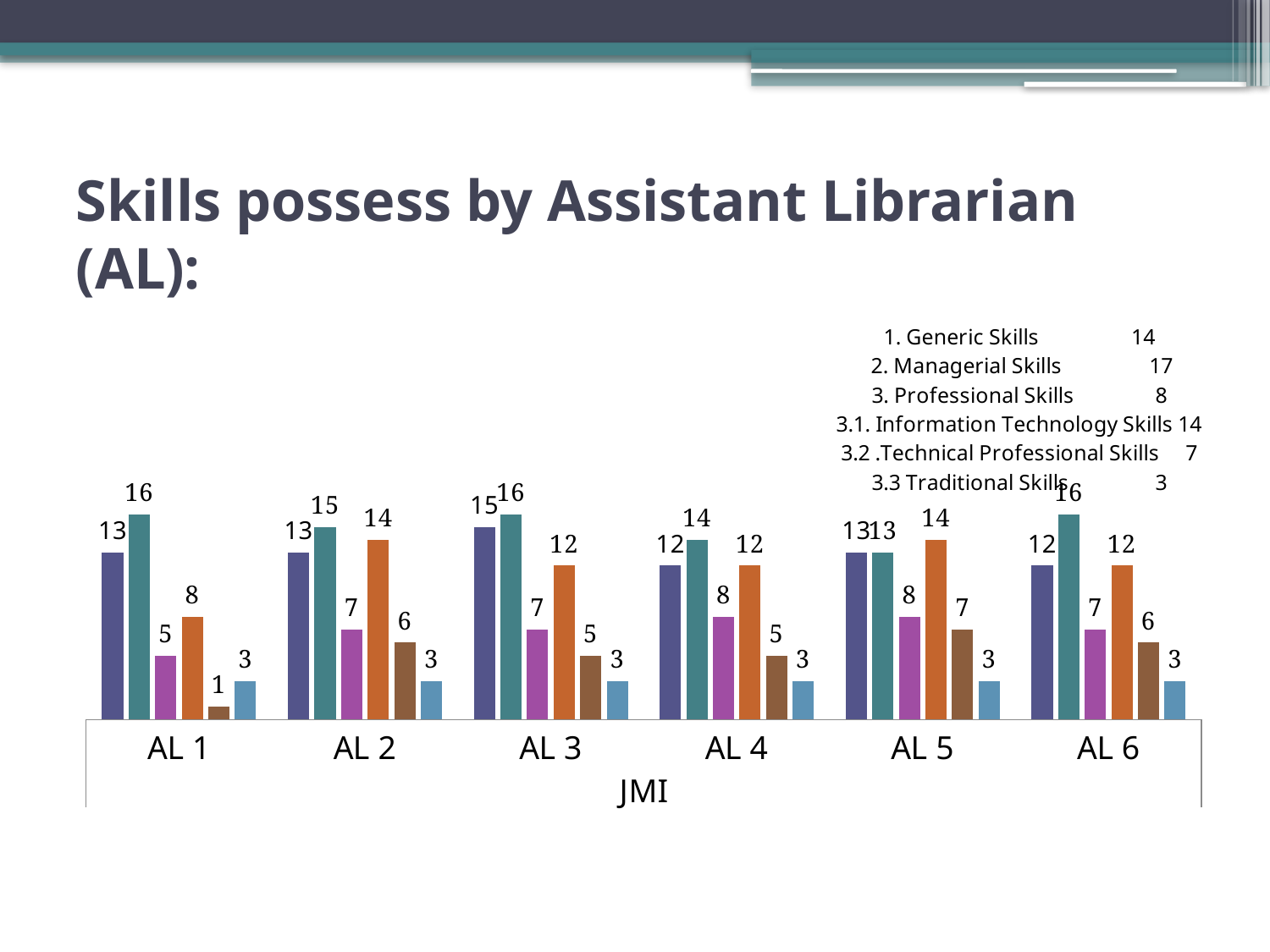
Which is larger, the teal (second) bar for AL 4 or the teal bar for AL 6? AL 6 Which AL category has the highest value for the dark blue (first) bar? AL 3 How many bars are plotted for each AL category? 6 What is the lowest value among the bars for AL 2? 3 How many categories (AL groups) are shown along the x axis? 6 What label appears beneath the AL categories on the x axis? JMI What is the value of the brown (fifth) bar for AL 1? 1 What is the value of the purple (third) bar for AL 5? 8 What kind of chart is shown on the slide? bar chart What is the sum of all six bar values for AL 1? 46 What is the value of the teal (second) bar for AL 1? 16 What is the difference between the orange (fourth) bar for AL 2 and the orange bar for AL 1? 6